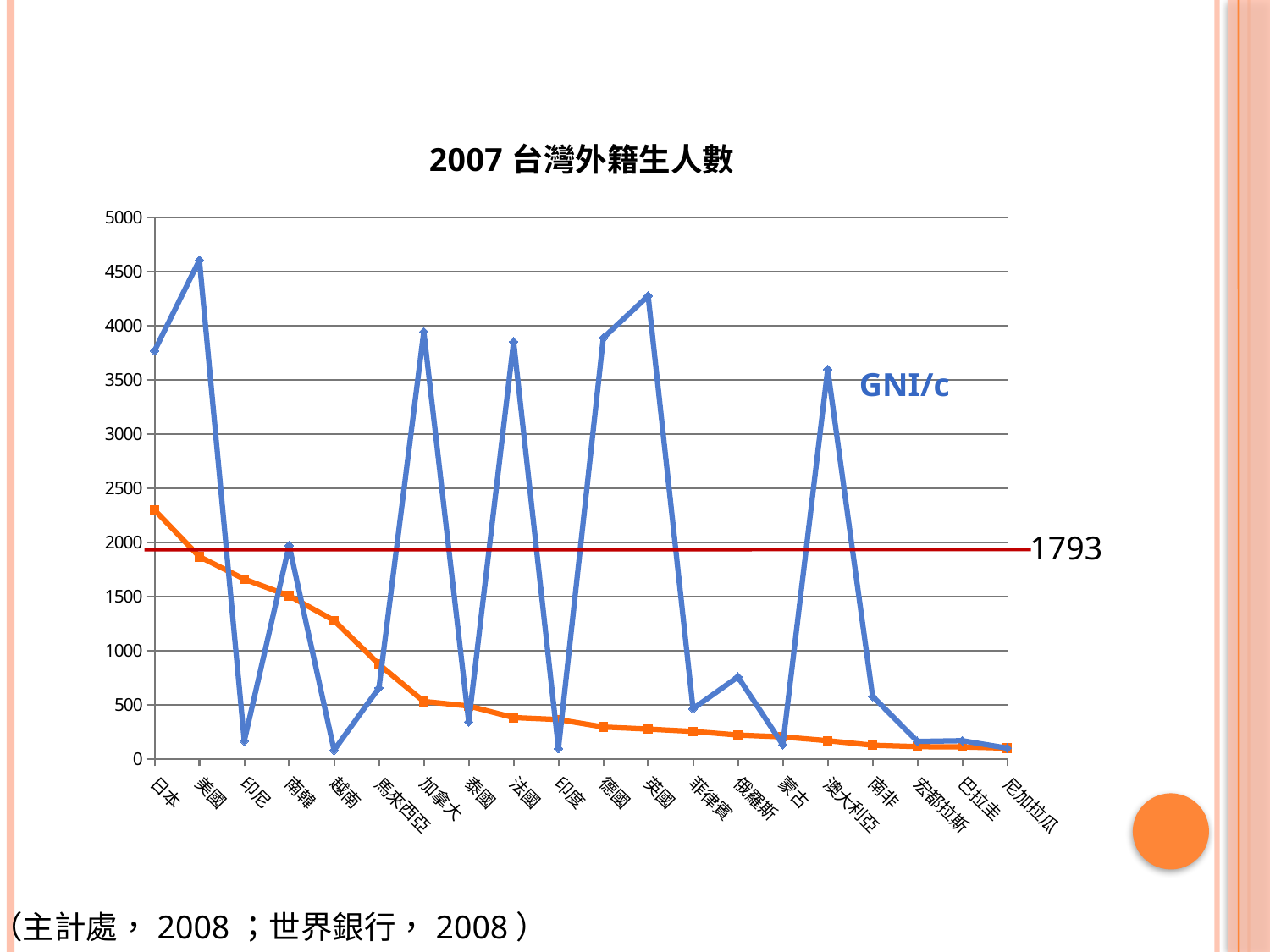
Which country has the highest value on the blue GNI/c line? 美國 What value is labelled on the red horizontal reference line? 1793 On the blue GNI/c line, which is larger: the value for 美國 or the value for 日本? 美國 Is the orange line value for 越南 greater or less than 1000? greater What kind of chart is shown on the slide? line chart Is the blue GNI/c value for 加拿大 greater or less than 3500? greater How many countries are listed along the x axis of the chart? 20 Is the orange line value for 日本 greater or less than 2000? greater What is the title of the chart? 2007 台灣外籍生人數 Does the orange line generally rise or fall from left to right along the x axis? fall Which country has the highest value on the orange line? 日本